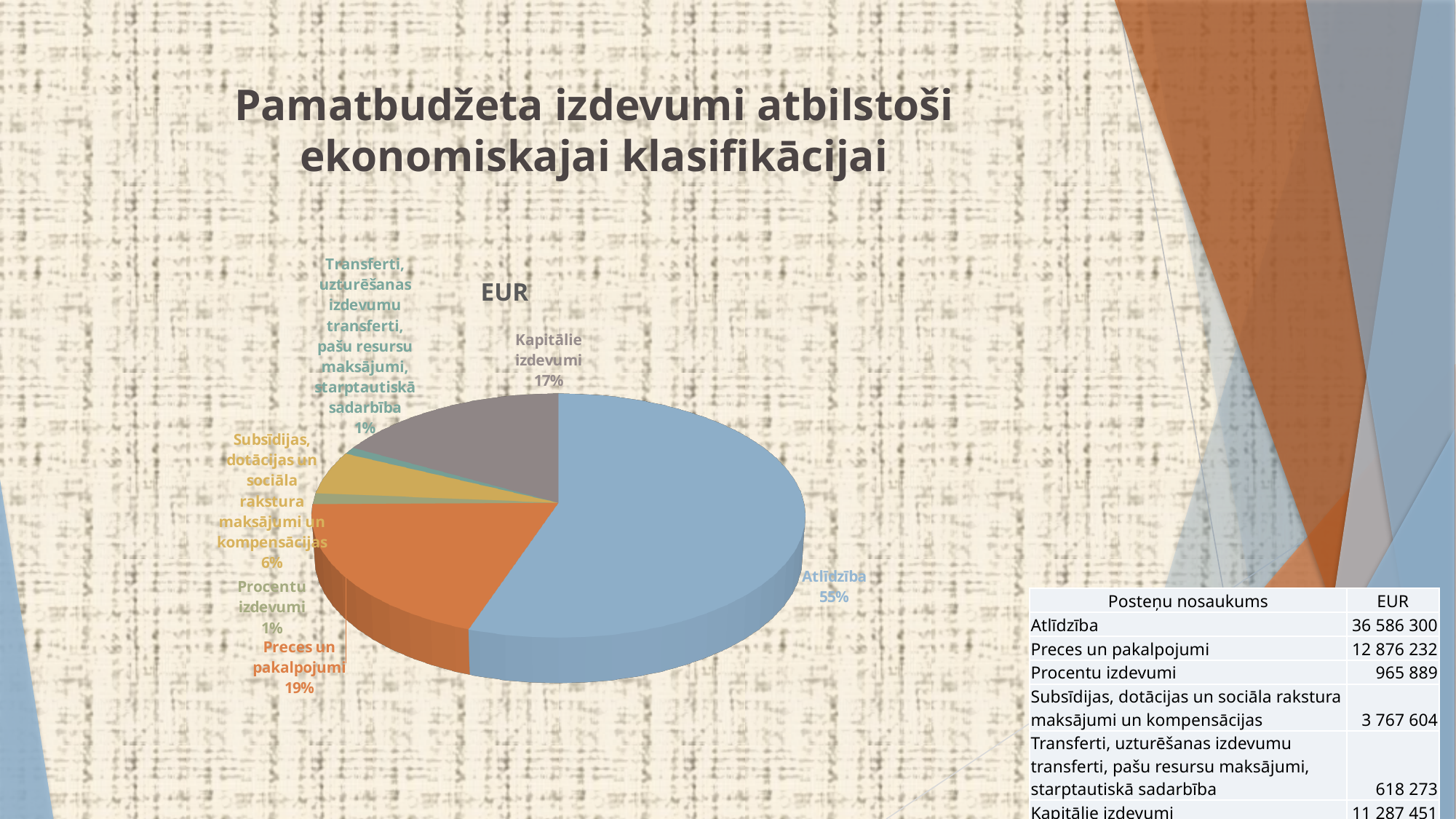
What share of the pie does Preces un pakalpojumi represent? 19% What percentage is shown for Procentu izdevumi? 1% How many slices does the pie chart have? 6 Which slice is larger, Preces un pakalpojumi or Kapitālie izdevumi? Preces un pakalpojumi What share of the pie does Atlīdzība represent? 55% What colour is the Atlīdzība slice in the pie chart? light blue What kind of chart is shown on the slide? pie chart What is the title of the pie chart? EUR By how many percentage points does the Atlīdzība share exceed the Preces un pakalpojumi share? 36 What share of the pie does Kapitālie izdevumi represent? 17% What percentage is shown for Subsīdijas, dotācijas un sociāla rakstura maksājumi un kompensācijas? 6% Which category has the largest slice of the pie? Atlīdzība